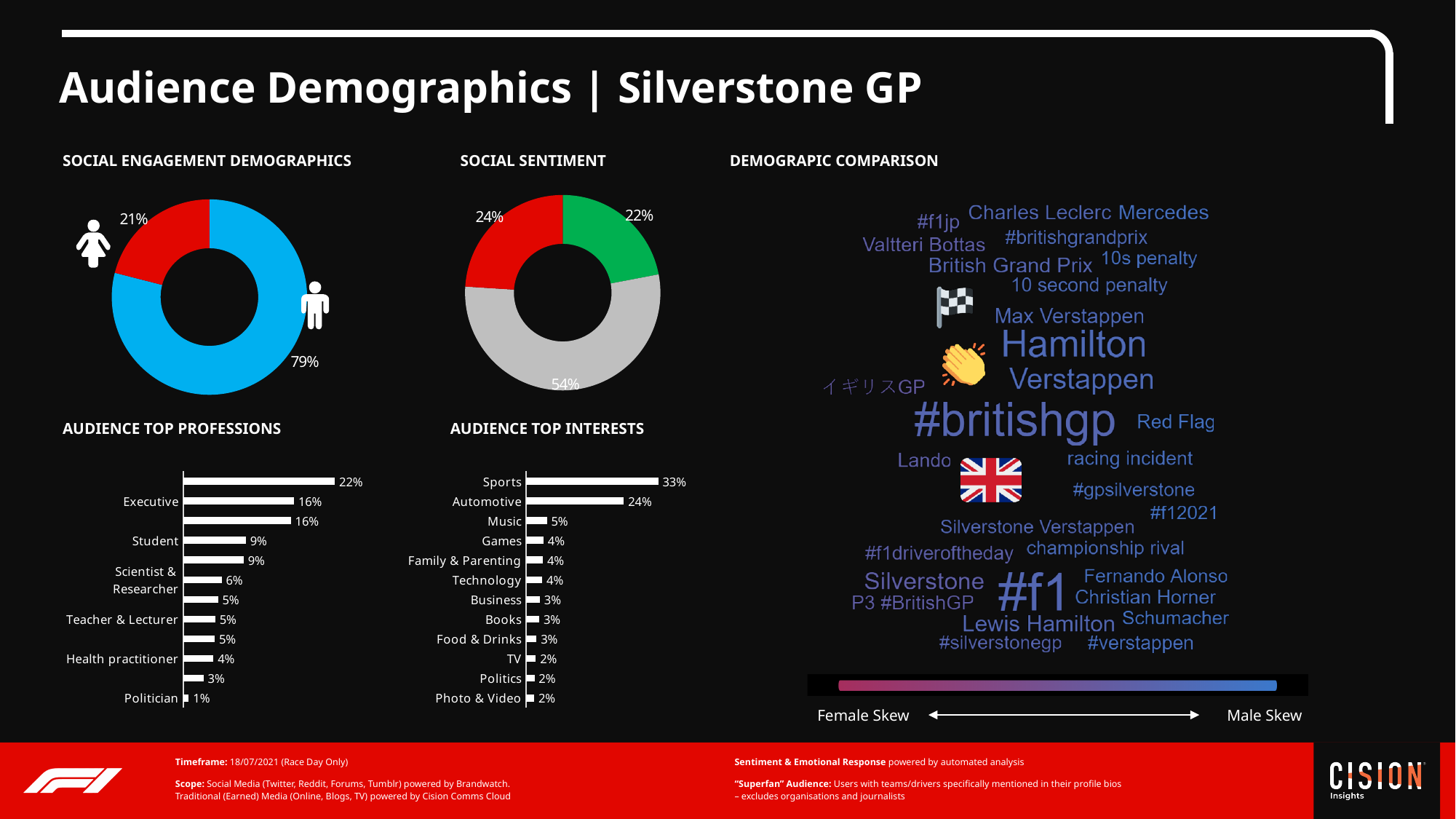
In the Audience Top Interests chart, what is the difference between Sports and Automotive? 9% In the Social Engagement Demographics chart, what is the difference between the male and female shares? 58% In the Social Sentiment chart, what percentage does the green segment represent? 22% In the Social Engagement Demographics chart, what percentage of the audience is female? 21% In the Social Engagement Demographics chart, what percentage of the audience is male? 79% In the Social Sentiment chart, what percentage does the grey segment represent? 54% In the Audience Top Professions chart, what is the difference between Student and Health practitioner? 5% In the Social Sentiment chart, how many segments does the donut have? 3 In the Audience Top Professions chart, what is the value for Executive? 16% In the Audience Top Interests chart, which category has the highest value? Sports In the Audience Top Professions chart, what is the value for Politician? 1% What kind of chart is the Audience Top Interests chart? Bar chart